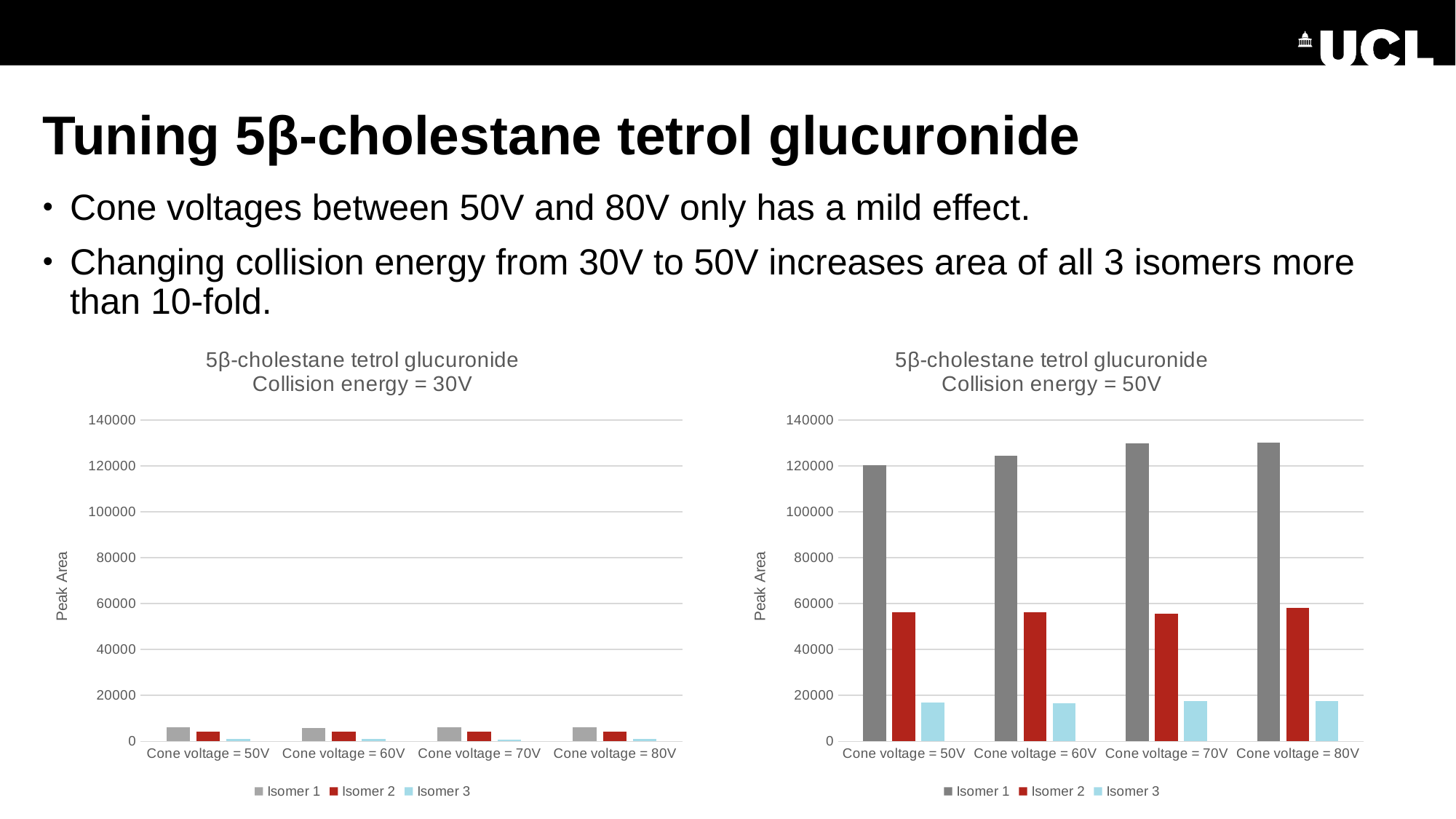
In the right chart (Collision energy = 50V), which isomer has the highest value at Cone voltage = 60V? Isomer 1 What is the y-axis label of the left chart (Collision energy = 30V)? Peak Area How many series does the legend of the right chart (Collision energy = 50V) list? 3 What is the title of the right chart? 5β-cholestane tetrol glucuronide Collision energy = 50V In the right chart (Collision energy = 50V), which isomer has the lowest value at Cone voltage = 80V? Isomer 3 In the right chart (Collision energy = 50V), which is larger at Cone voltage = 70V: Isomer 1 or Isomer 2? Isomer 1 In the right chart (Collision energy = 50V), is the value for Isomer 2 at Cone voltage = 80V greater or less than 40000? greater What kind of chart is the left chart (Collision energy = 30V)? bar chart In the left chart (Collision energy = 30V), is the value for Isomer 1 at Cone voltage = 50V greater or less than 20000? less In the right chart (Collision energy = 50V), is the value for Isomer 1 at Cone voltage = 50V greater or less than 100000? greater How many cone voltage categories are shown on the x axis of the right chart (Collision energy = 50V)? 4